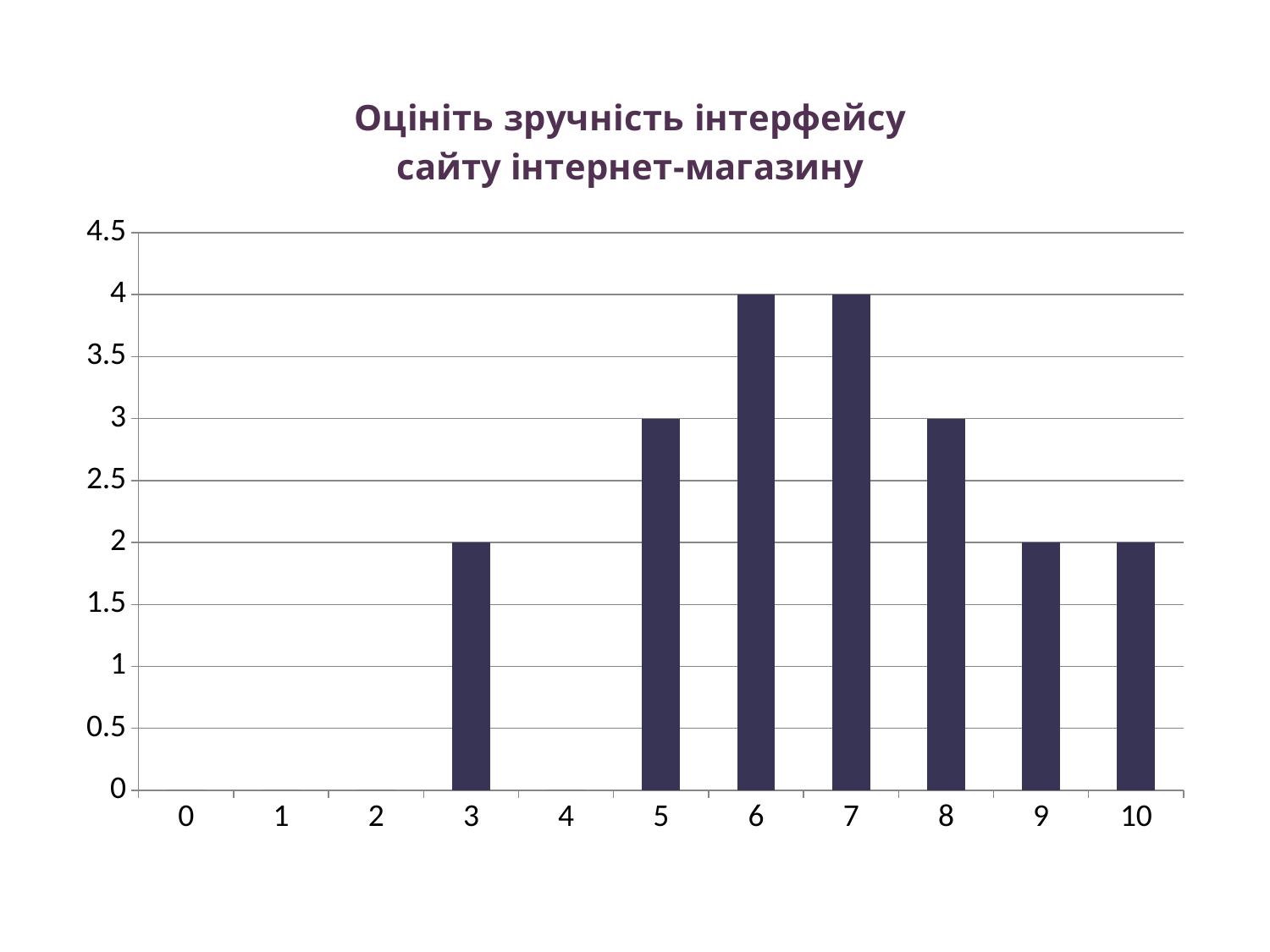
What is the value for category 3? 2 How many categories are shown on the x axis? 11 What is the difference between the values for category 6 and category 3? 2 What is the highest value reached by any bar on the chart? 4 What is the value for category 5? 3 What is the value for category 8? 3 What is the value for category 10? 2 Do the values rise or fall from category 7 to category 10? fall What kind of chart is shown on the slide? bar chart What is the value for category 6? 4 Is the value for category 7 greater or less than 3? greater Which has the larger value, category 5 or category 9? 5